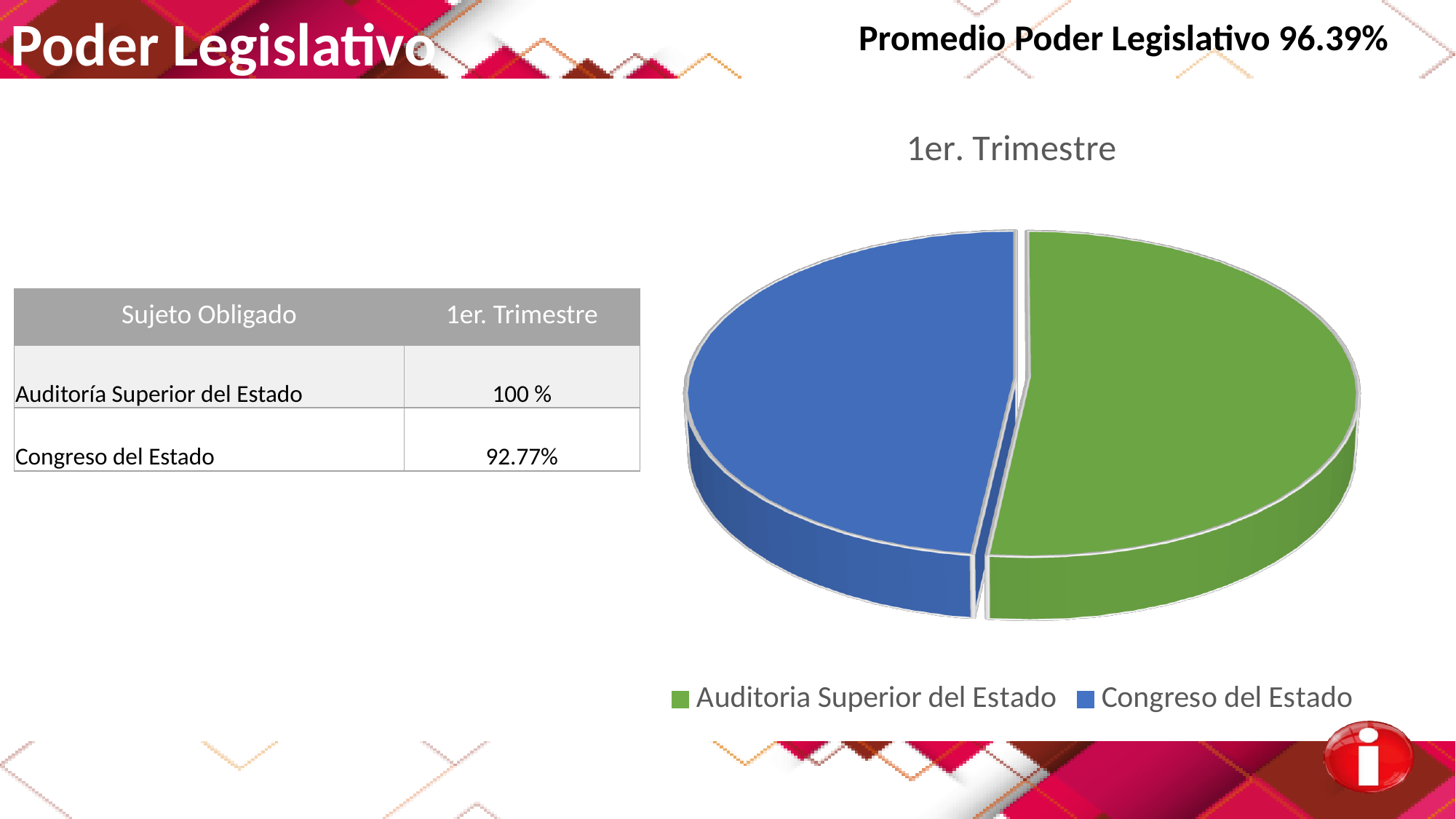
Which of the two sujetos obligados has the lower 1er. Trimestre value? Congreso del Estado What is the title of the pie chart? 1er. Trimestre Which of the two sujetos obligados has the higher 1er. Trimestre value? Auditoría Superior del Estado What is the Promedio Poder Legislativo stated on the slide? 96.39% According to the table, what is the 1er. Trimestre value for Congreso del Estado? 92.77% How many slices does the pie chart have? 2 What kind of chart is shown on the slide? Pie chart Which legend entry is shown in green in the pie chart? Auditoria Superior del Estado How many entries does the pie chart's legend list? 2 According to the table, what is the 1er. Trimestre value for Auditoría Superior del Estado? 100 % Is the 1er. Trimestre value for Auditoría Superior del Estado larger or smaller than that for Congreso del Estado? Larger What is the difference in percentage points between the 1er. Trimestre values of Auditoría Superior del Estado and Congreso del Estado? 7.23